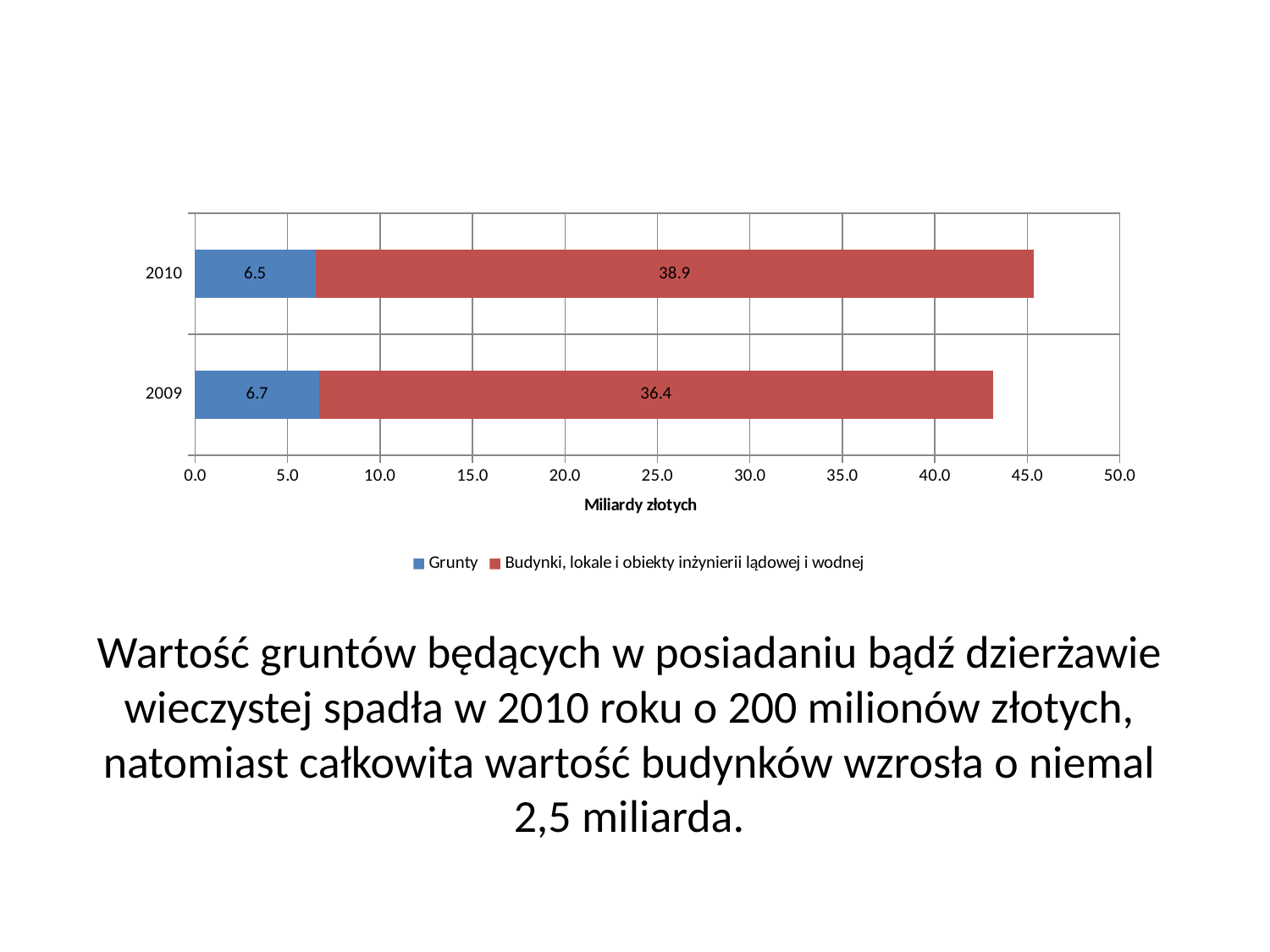
What is the total of the stacked bar for 2009? 43.1 What is the total of the stacked bar for 2010? 45.4 How many series does the legend list? 2 What is the value for Grunty in 2010? 6.5 Which year has the lower value for Grunty? 2010 What is the value for Grunty in 2009? 6.7 What is the x-axis title of the chart? Miliardy złotych What is the value for Budynki, lokale i obiekty inżynierii lądowej i wodnej in 2009? 36.4 Which year has the higher value for Budynki, lokale i obiekty inżynierii lądowej i wodnej? 2010 What is the value for Budynki, lokale i obiekty inżynierii lądowej i wodnej in 2010? 38.9 What is the difference between the Budynki values for 2010 and 2009? 2.5 What kind of chart is shown on the slide? Stacked bar chart